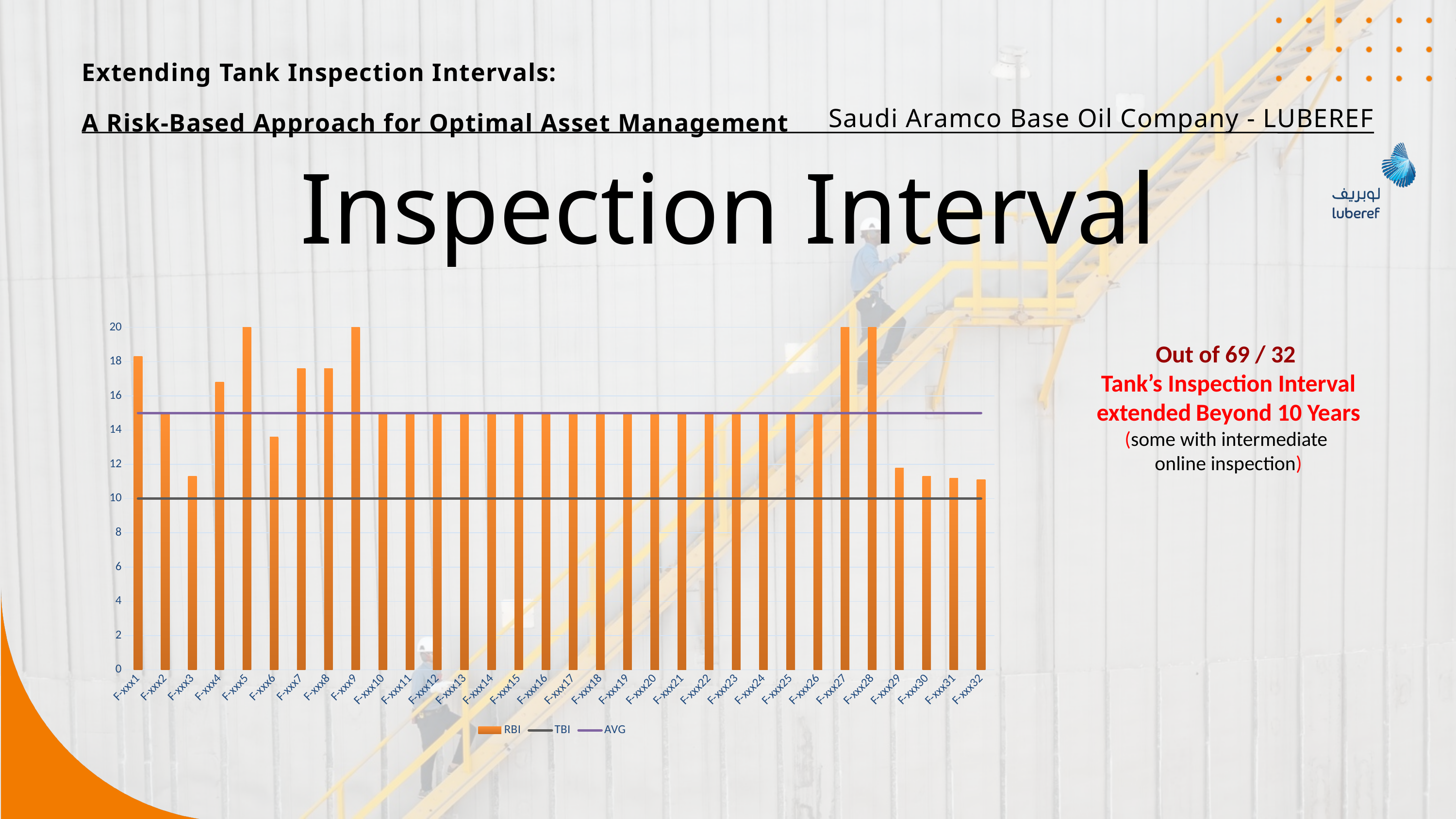
Is the RBI value for F-xxx3 greater or less than 12? less What is the RBI value for F-xxx5? 20 Which has the larger RBI value, F-xxx1 or F-xxx3? F-xxx1 Is the RBI value for F-xxx4 greater or less than 16? greater What is the RBI value for F-xxx27? 20 At what value does the TBI line sit on the chart? 10 What are the series names listed in the chart legend? RBI, TBI, AVG How many series does the chart legend list? 3 How many tank categories are shown on the x axis of the chart? 32 Is the RBI value for F-xxx6 greater or less than 12? greater Which has the larger RBI value, F-xxx5 or F-xxx6? F-xxx5 What kind of chart is shown on the slide? bar chart